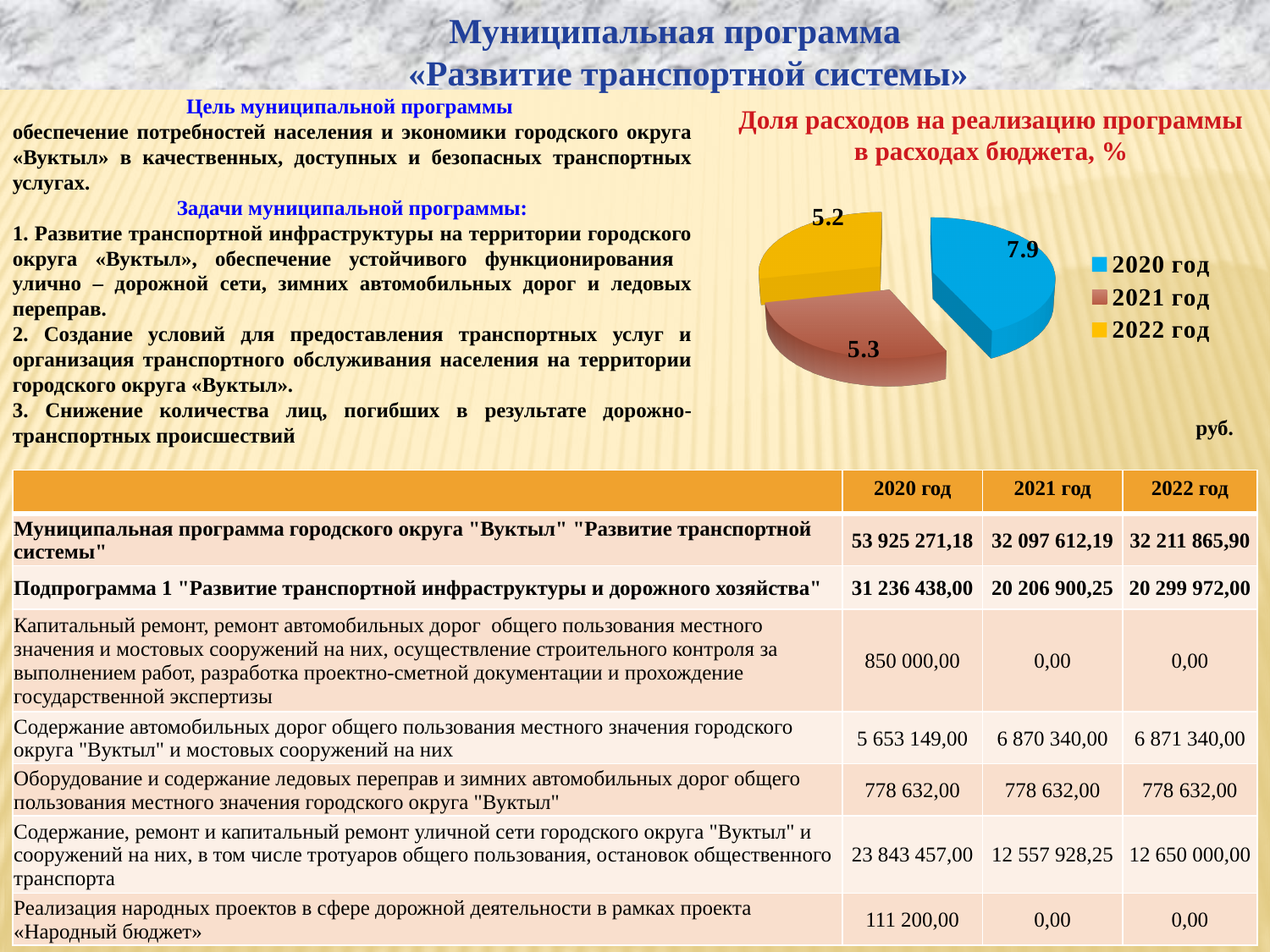
Which year has the largest slice in the pie chart? 2020 год What is the title of the pie chart? Доля расходов на реализацию программы в расходах бюджета, % What kind of chart is shown on the slide? pie chart Which is larger in the pie chart, the value for 2020 год or the value for 2022 год? 2020 год How many slices does the pie chart have? 3 Which year has the smallest slice in the pie chart? 2022 год What is the difference between the values for 2021 год and 2022 год in the pie chart? 0.1 What value is shown for 2022 год in the pie chart? 5.2 What is the difference between the values for 2020 год and 2021 год in the pie chart? 2.6 How many entries does the legend of the pie chart list? 3 What value is shown for 2020 год in the pie chart? 7.9 What value is shown for 2021 год in the pie chart? 5.3